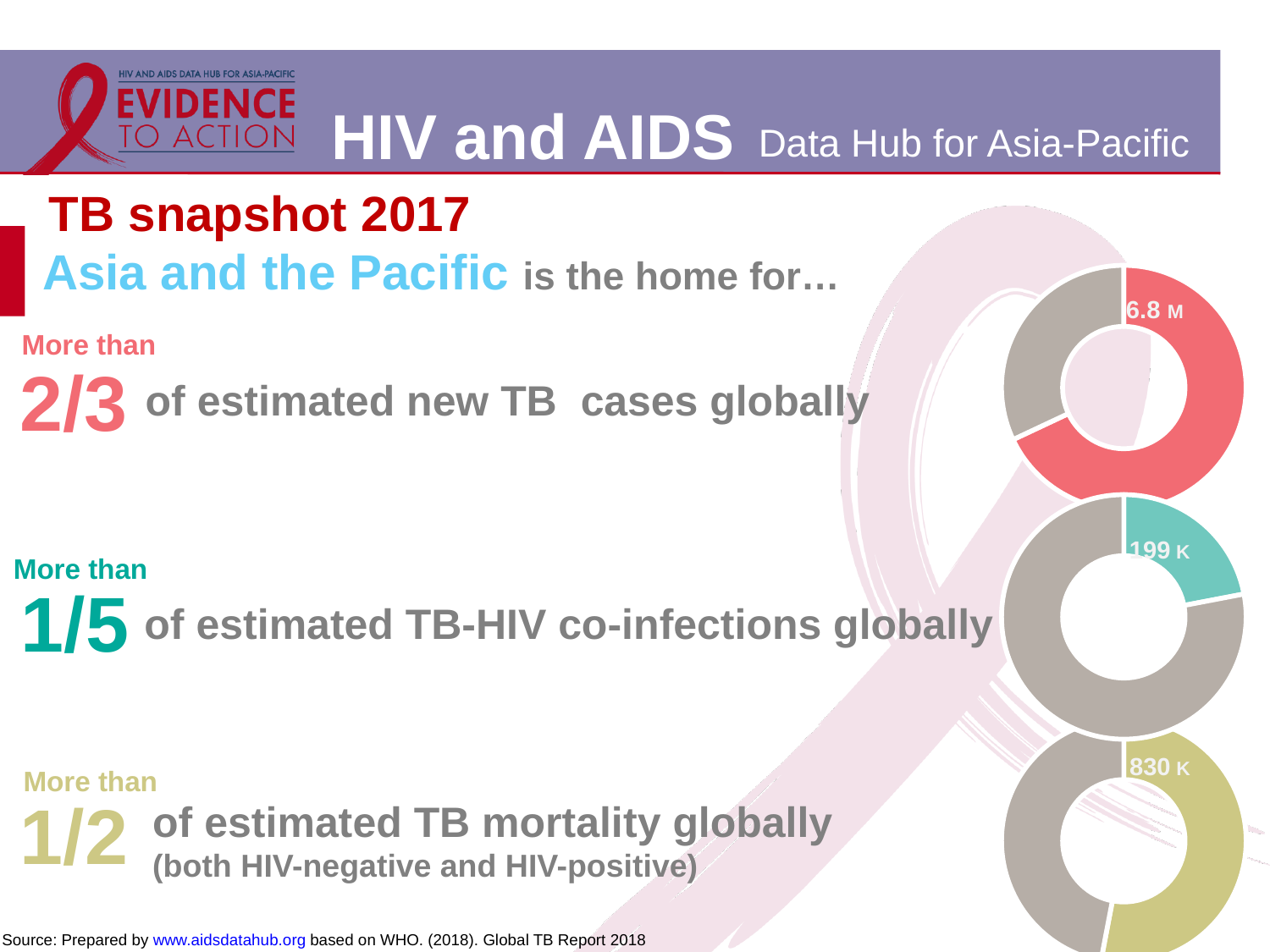
What colour is the highlighted slice in the middle donut chart? Teal How many donut charts are shown on the slide? 3 Which of the three donut charts has the smallest coloured share? The middle chart (TB-HIV co-infections, 199 K) What colour is the highlighted slice in the bottom donut chart? Yellow Roughly what share of the top donut chart does the red slice represent, according to the slide text? More than 2/3 In the middle donut chart, is the coloured (teal) slice larger or smaller than the grey slice? Smaller What value is labelled on the coloured slice of the bottom donut chart (TB mortality)? 830 K What value is labelled on the coloured slice of the middle donut chart (TB-HIV co-infections)? 199 K What kind of chart is used on the right side of the slide? Donut (pie) chart In the top donut chart, is the coloured (red) slice larger or smaller than the grey slice? Larger What value is labelled on the coloured slice of the top donut chart (new TB cases)? 6.8 M Which of the three donut charts has the largest coloured share? The top chart (new TB cases, 6.8 M)